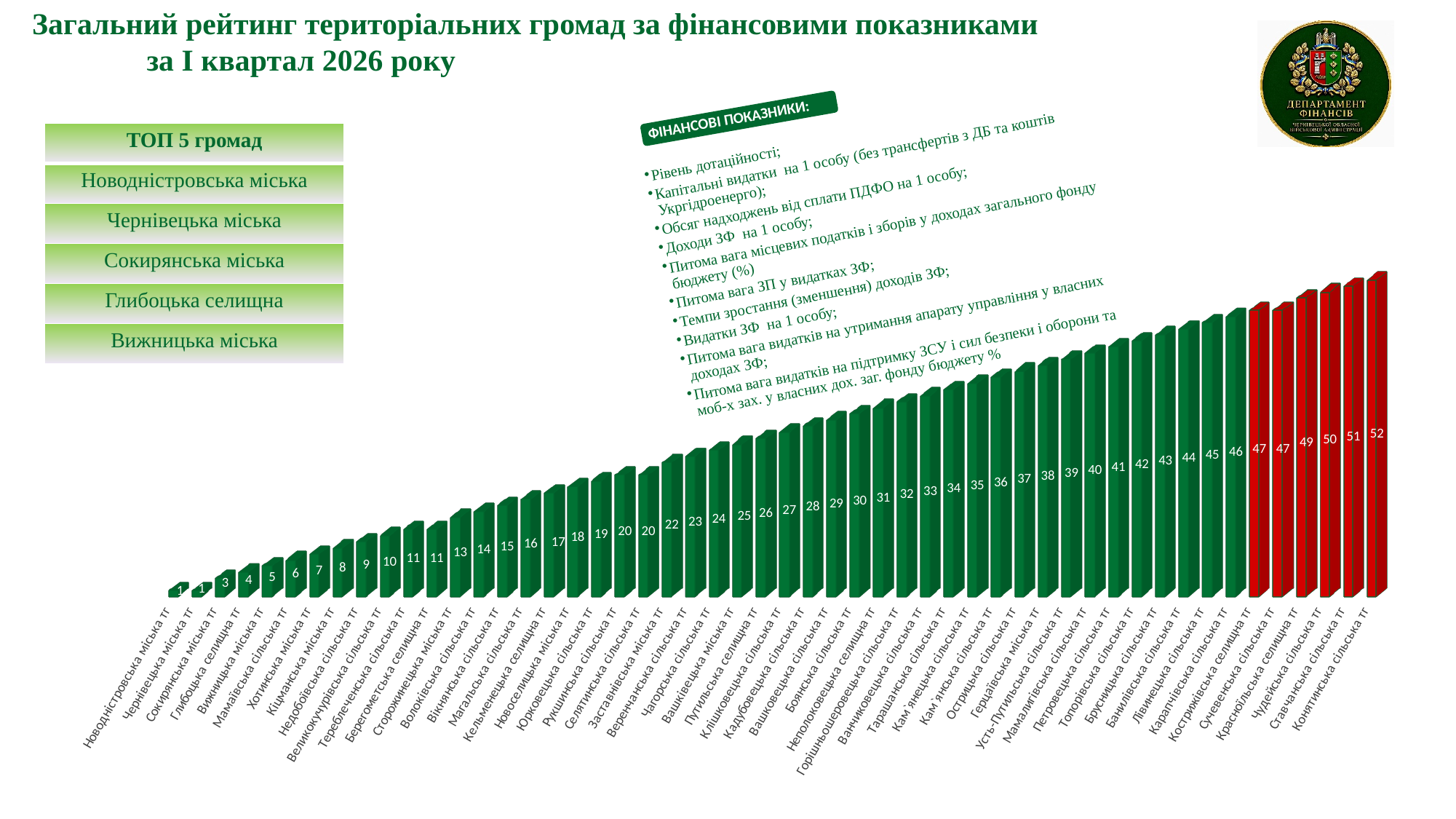
Which has a larger value, Хотинська міська тг or Вашківецька міська тг? Вашківецька міська тг What kind of chart is shown on the slide? bar chart What is the lowest value shown in the chart? 1 What value is shown for Герцаївська міська тг? 38 What value is shown for Сокирянська міська тг? 3 What is the difference between the values for Конятинська сільська тг and Новодністровська міська тг? 51 Which community has the highest value in the chart? Конятинська сільська тг Do the values rise or fall from left to right along the x axis? rise What value is shown for Конятинська сільська тг? 52 How many bars are coloured red in the chart? 6 How many communities (bars) are shown in the chart? 52 What value is shown for Сторожинецька міська тг? 13